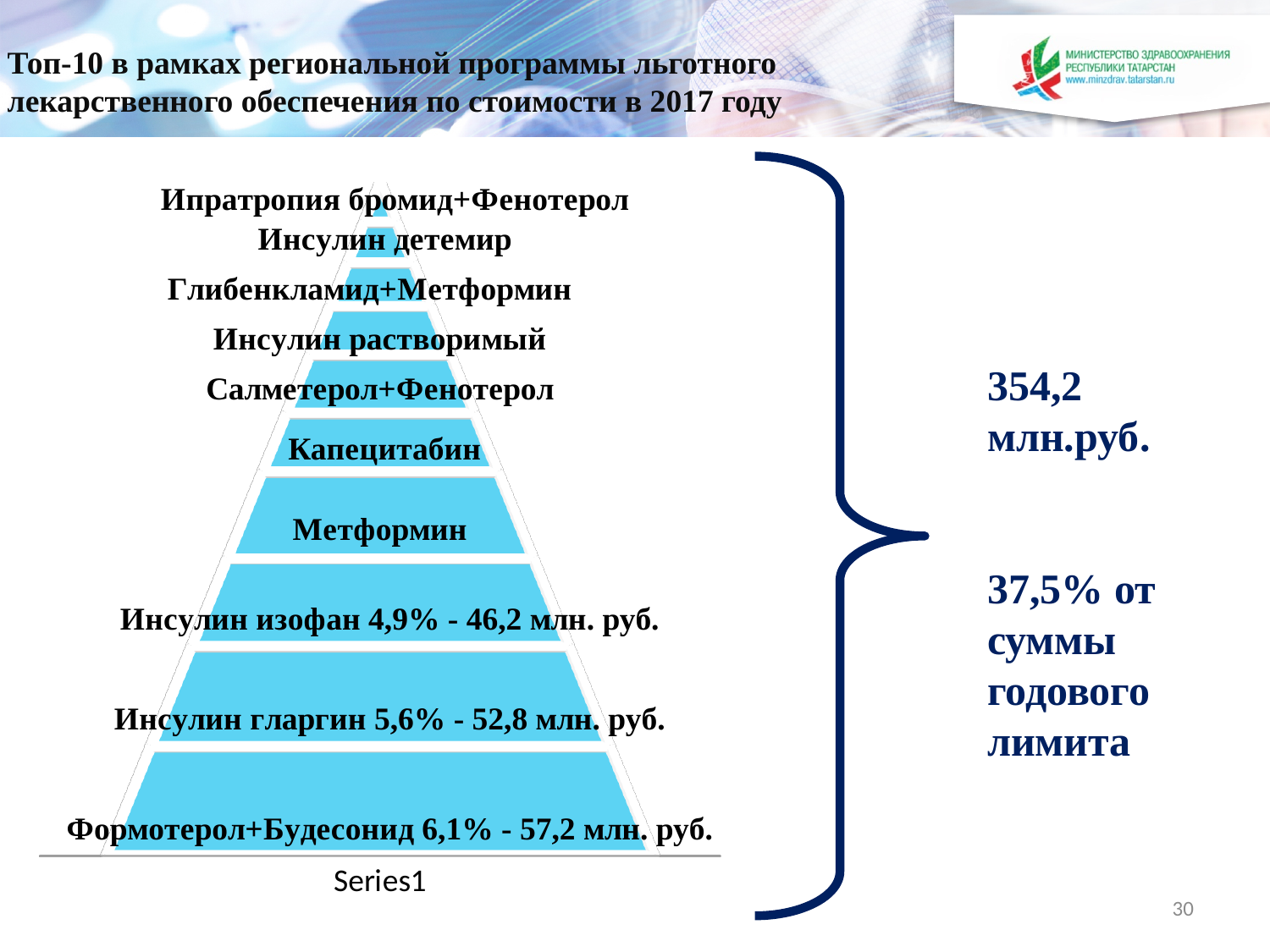
What is the cost value shown for Формотерол+Будесонид? 57,2 млн. руб. Which drug category has the largest segment in the pyramid chart? Формотерол+Будесонид What is the legend entry shown below the pyramid chart? Series1 Which drug category has the smallest segment in the pyramid chart? Ипратропия бромид+Фенотерол What is the difference in cost between Инсулин гларгин and Инсулин изофан? 6,6 млн. руб. How many series does the legend of the chart list? 1 What kind of chart is shown on the slide? Pyramid chart Which segment is larger in the pyramid chart, Метформин or Капецитабин? Метформин What percentage is shown for Инсулин гларгин? 5,6% How many drug categories are shown in the pyramid chart? 10 What is the cost value shown for Инсулин изофан? 46,2 млн. руб. What is the difference in cost between Формотерол+Будесонид and Инсулин гларгин? 4,4 млн. руб.